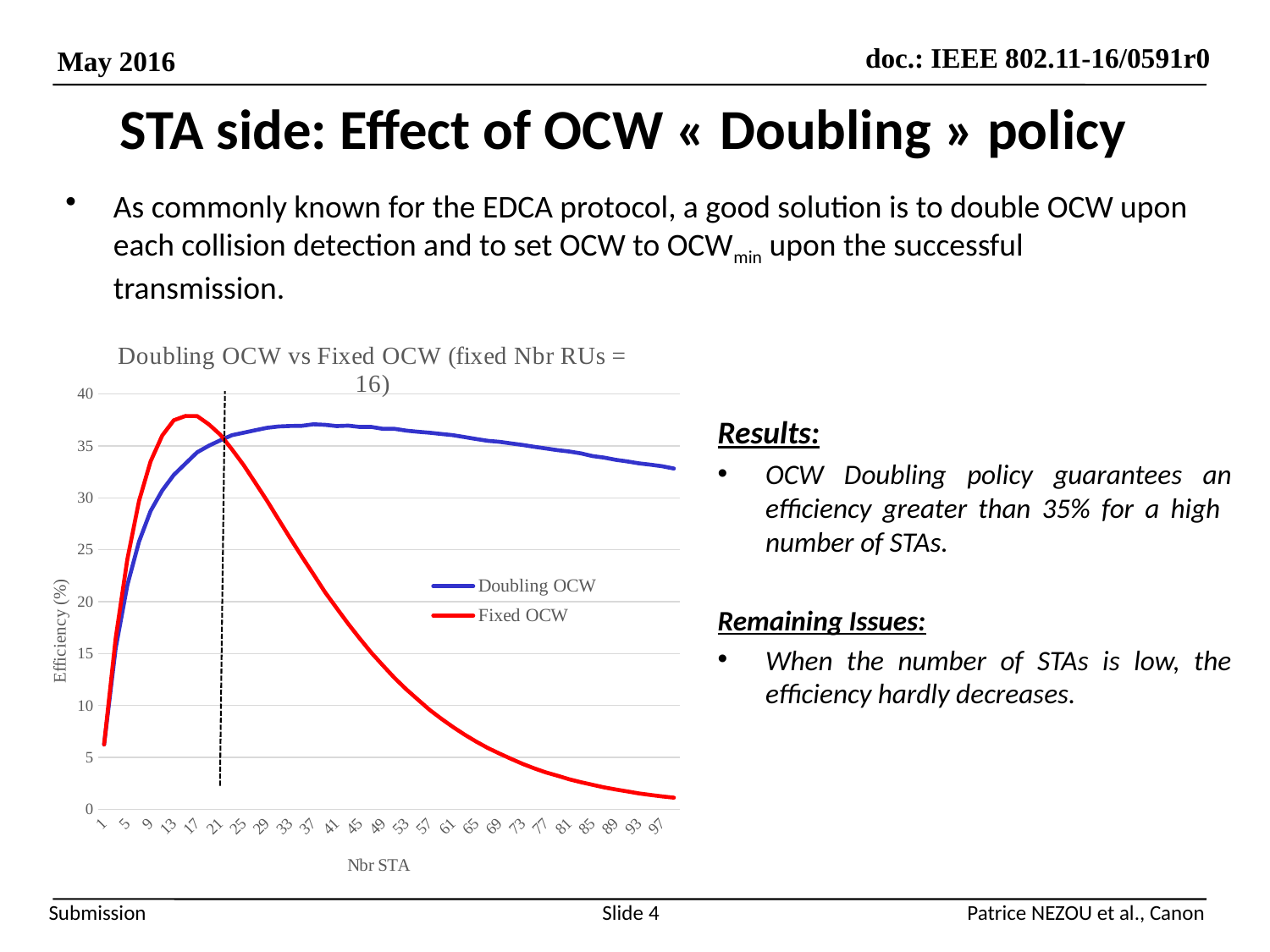
Is the peak value of the Fixed OCW series greater or less than 35? greater What is the title of the chart? Doubling OCW vs Fixed OCW (fixed Nbr RUs = 16) Does the Fixed OCW series rise or fall as Nbr STA increases from 21 to 97? fall What kind of chart is shown on the slide? line chart At Nbr STA 13, which series has the higher efficiency, Doubling OCW or Fixed OCW? Fixed OCW How many series does the chart legend list? 2 Is the Fixed OCW value at Nbr STA 97 greater or less than 5? less Is the Fixed OCW value at Nbr STA 61 greater or less than 10? less What is the label of the vertical axis of the chart? Efficiency (%) At Nbr STA 97, which series has the higher efficiency, Doubling OCW or Fixed OCW? Doubling OCW